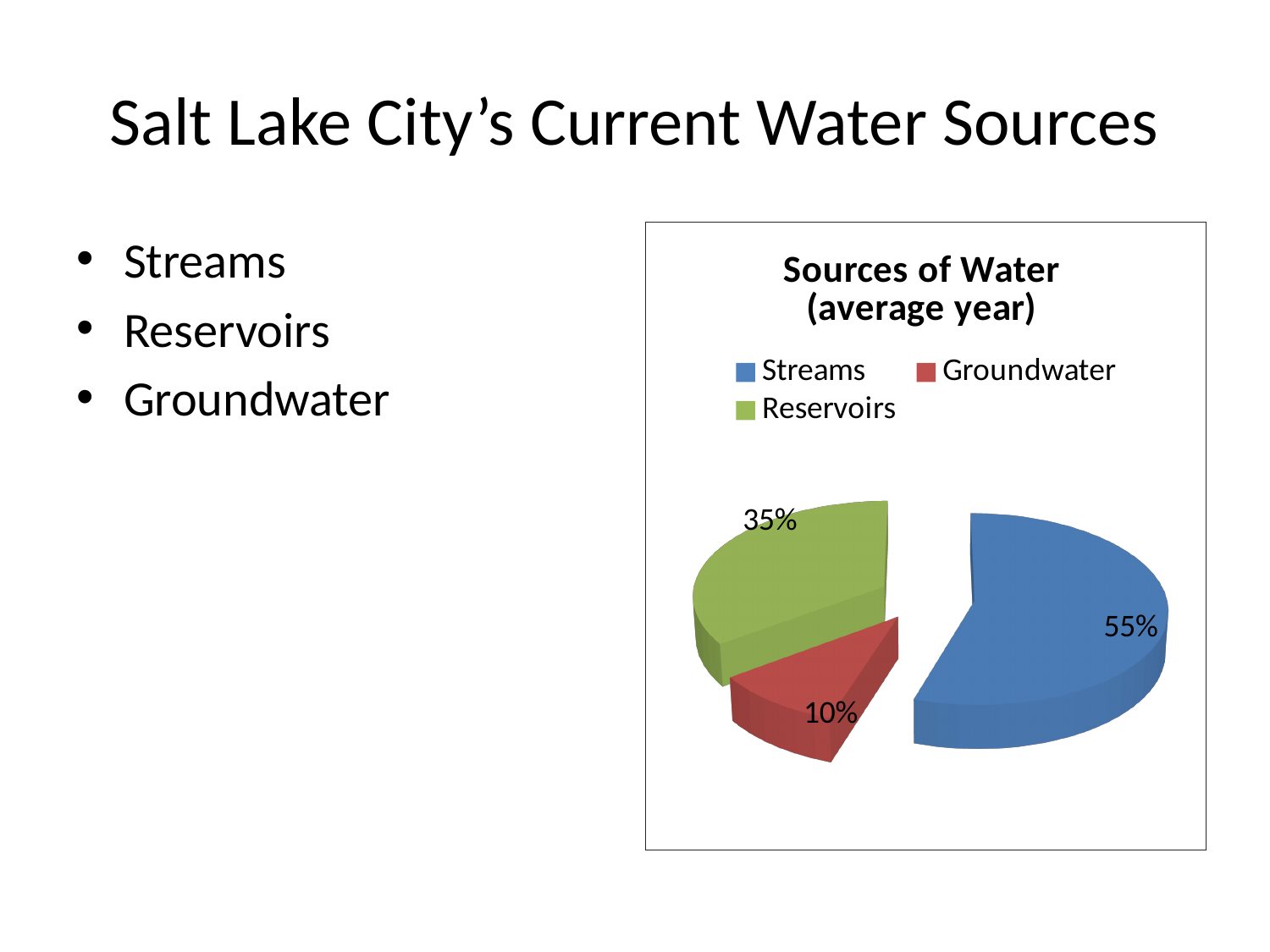
Which water source has the smallest share of the pie? Groundwater How many categories are shown in the pie chart? 3 What share of the pie does Streams account for? 55% What is the difference in percentage points between the Reservoirs share and the Groundwater share? 25% What share of the pie does Reservoirs account for? 35% What is the title of the chart? Sources of Water (average year) What kind of chart is shown on the slide? Pie chart Which water source has the largest share of the pie? Streams Which has a larger share, Reservoirs or Groundwater? Reservoirs What share of the pie does Groundwater account for? 10% What is the difference in percentage points between the Streams share and the Reservoirs share? 20% Which colour represents Groundwater in the chart? Red